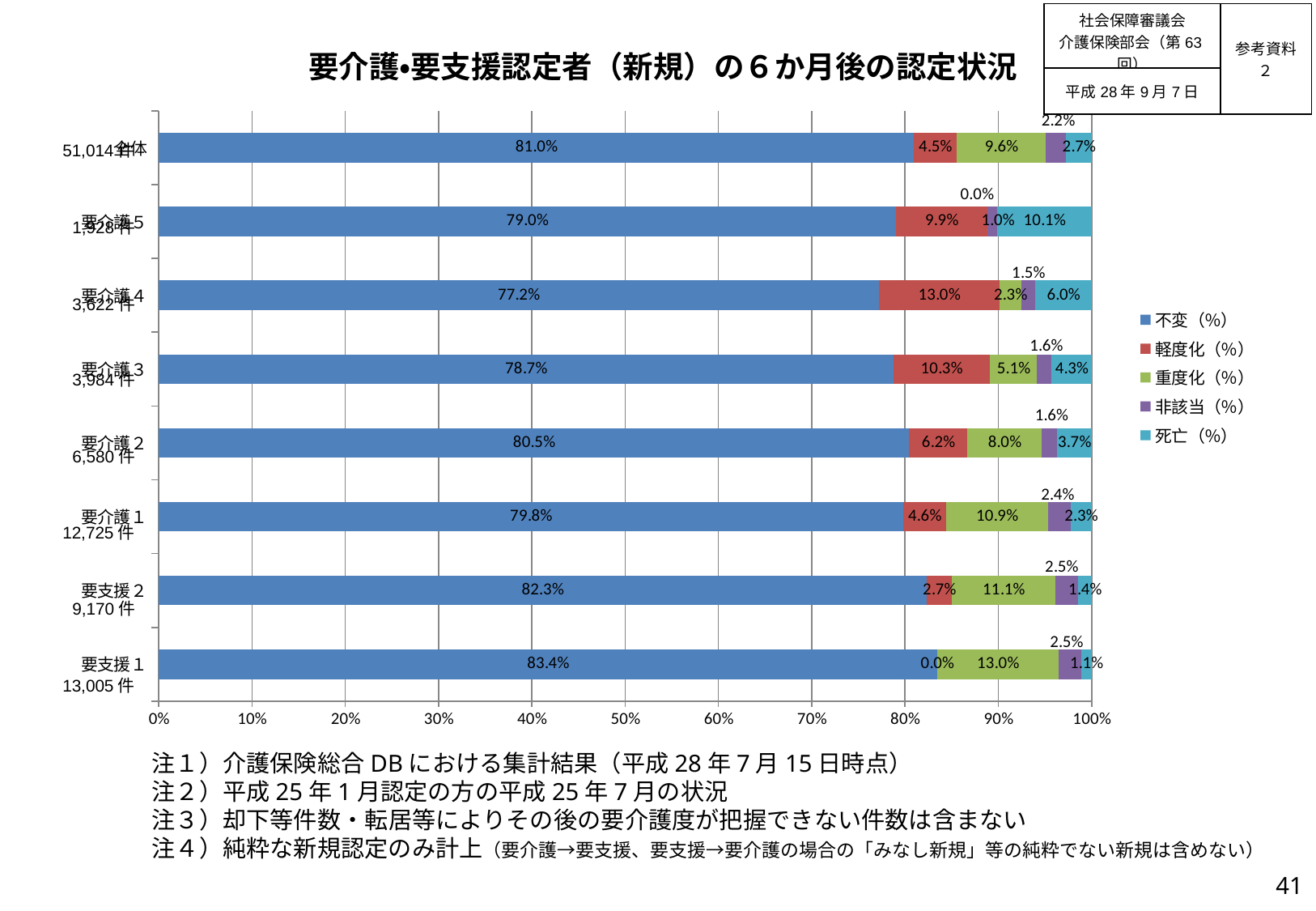
How many categories are plotted on the chart? 8 What is the 軽度化（%） value for 要介護４? 13.0% Which is larger, the 重度化（%） value for 要支援２ or for 要介護１? 要支援２ Which series is shown in blue in the legend? 不変（%） Which category has the highest 不変（%） value? 要支援１ What is the 重度化（%） value for 全体? 9.6% How many series does the legend list? 5 What is the 不変（%） value for 要支援１? 83.4% What type of chart is shown on the slide? Stacked bar chart Which category has the lowest 不変（%） value? 要介護４ What is the 死亡（%） value for 要介護５? 10.1% What is the difference between the 軽度化（%） values for 要介護４ and 要介護５? 3.1%